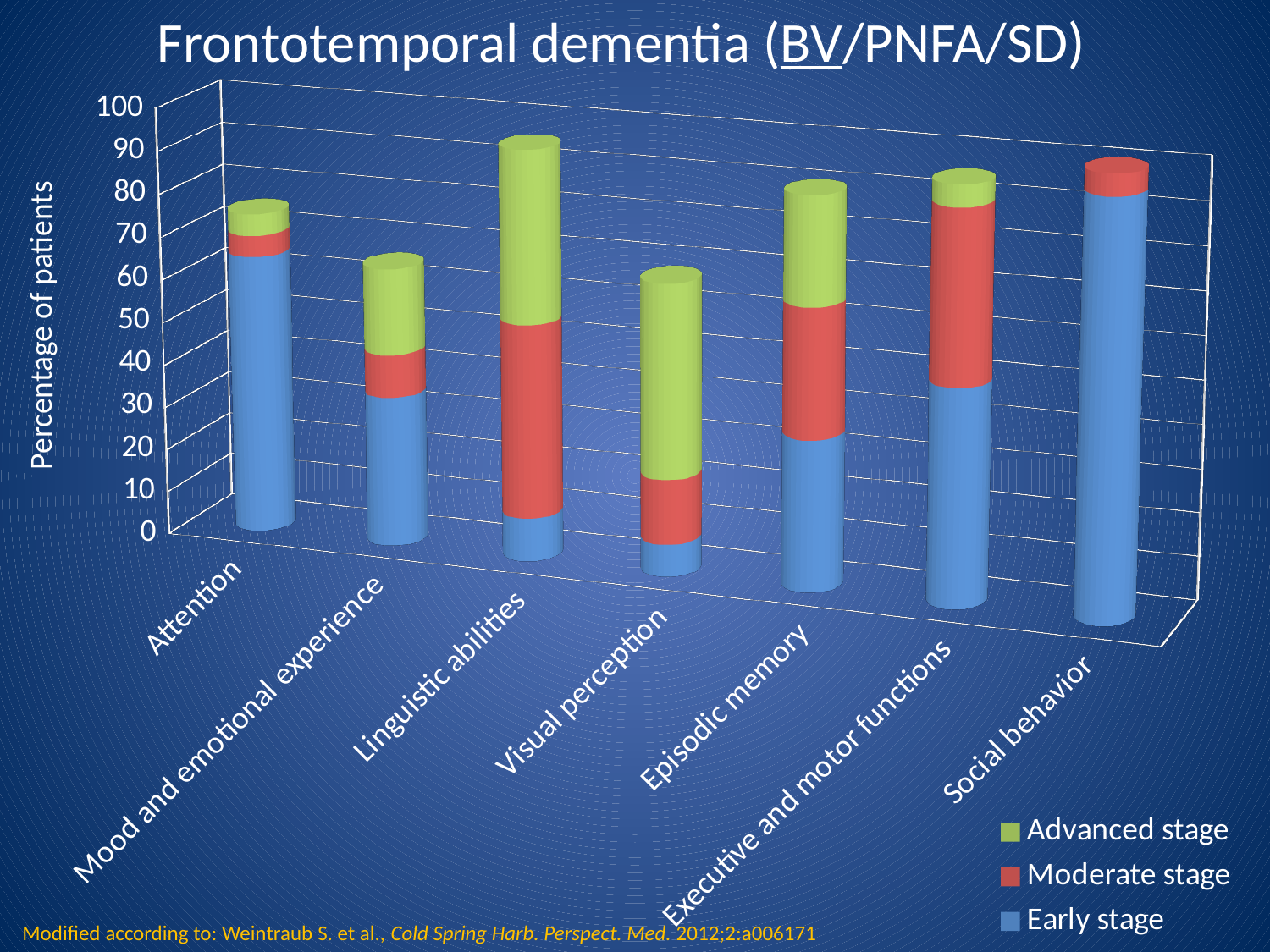
How many series does the chart's legend list? 3 Which category has the largest Early stage segment? Social behavior Which category has no Advanced stage segment at all? Social behavior What kind of chart is shown on the slide? Stacked bar chart Which has the larger Early stage segment, Attention or Mood and emotional experience? Attention Is the Early stage value for Linguistic abilities greater or less than 20? less What is the label of the vertical axis? Percentage of patients What is the title of the chart? Frontotemporal dementia (BV/PNFA/SD) How many categories are shown along the x axis of the chart? 7 Is the Early stage value for Social behavior greater or less than 50? greater Is the Early stage value for Attention greater or less than 50? greater